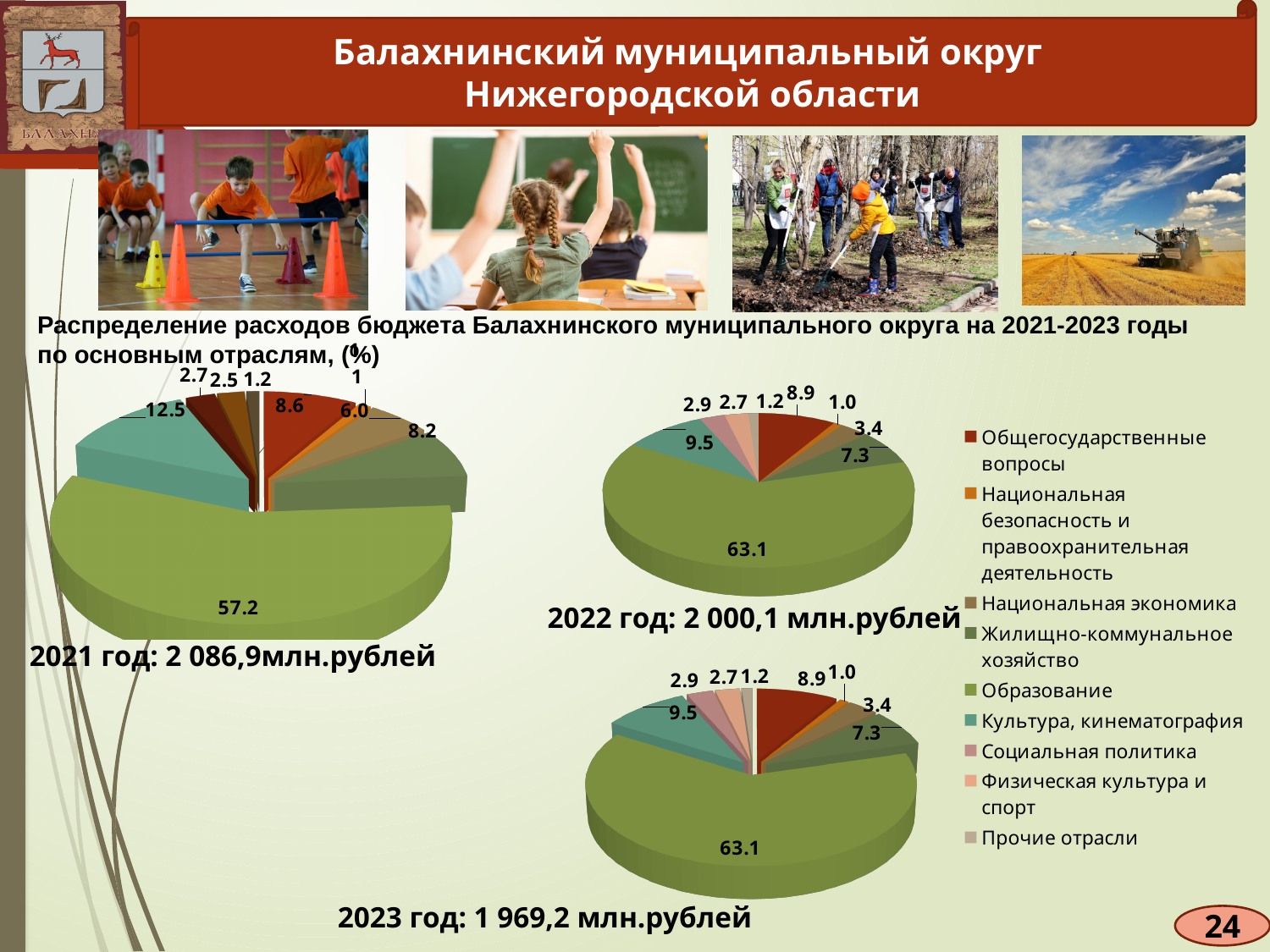
In the 2021 pie chart, what is the share of the largest slice (Образование)? 57.2 In the 2022 pie chart, what is the share for Жилищно-коммунальное хозяйство? 7.3 In the 2022 pie chart, what is the share for Общегосударственные вопросы? 8.9 In the 2022 pie chart, what is the share for Образование? 63.1 In the 2022 pie chart, which category has the largest share? Образование Which is larger: the largest slice in the 2021 pie chart (57.2) or the largest slice in the 2023 pie chart (63.1)? 2023 (63.1) By how many percentage points is the Образование share in the 2022 pie chart larger than in the 2021 pie chart? 5.9 What total budget amount is stated under the 2021 pie chart? 2 086,9 млн.рублей How many categories does the legend list? 9 How many pie charts are on the slide? 3 What kind of charts are shown on the slide? Pie charts In the 2023 pie chart, what is the share for Образование? 63.1